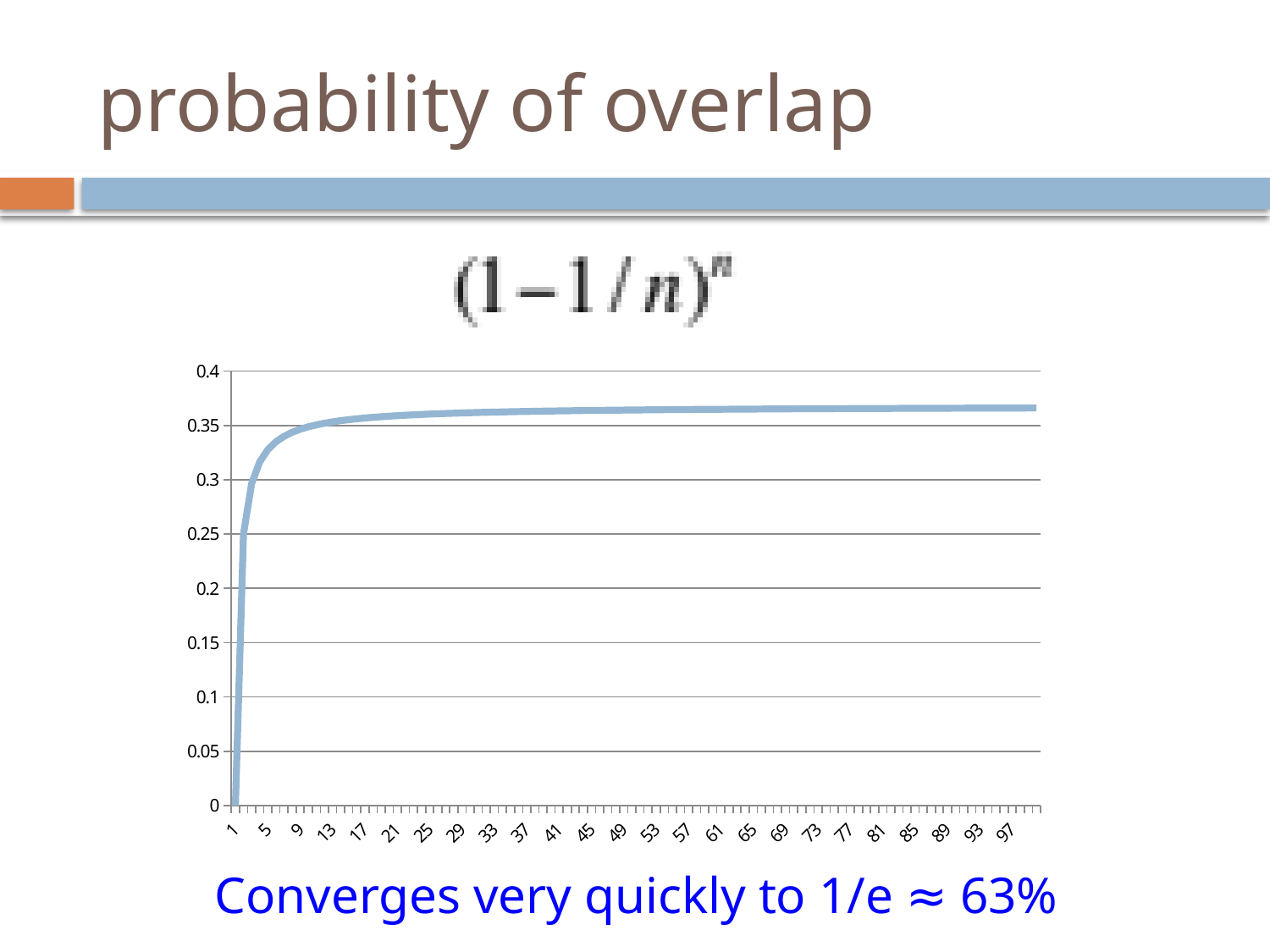
Is the value at x = 49 greater or less than 0.35? greater At which x-axis label is the plotted value lowest? 1 What formula is shown above the chart? (1 − 1/n)^n What kind of chart is shown on the slide? line chart How many labels are printed along the x axis? 25 Is the value at x = 9 greater or less than 0.3? greater Is the value at x = 97 greater or less than 0.35? greater Do the plotted values rise or fall as n increases along the x axis? rise Which is larger, the value at x = 1 or the value at x = 5? x = 5 What is the highest tick value shown on the y axis? 0.4